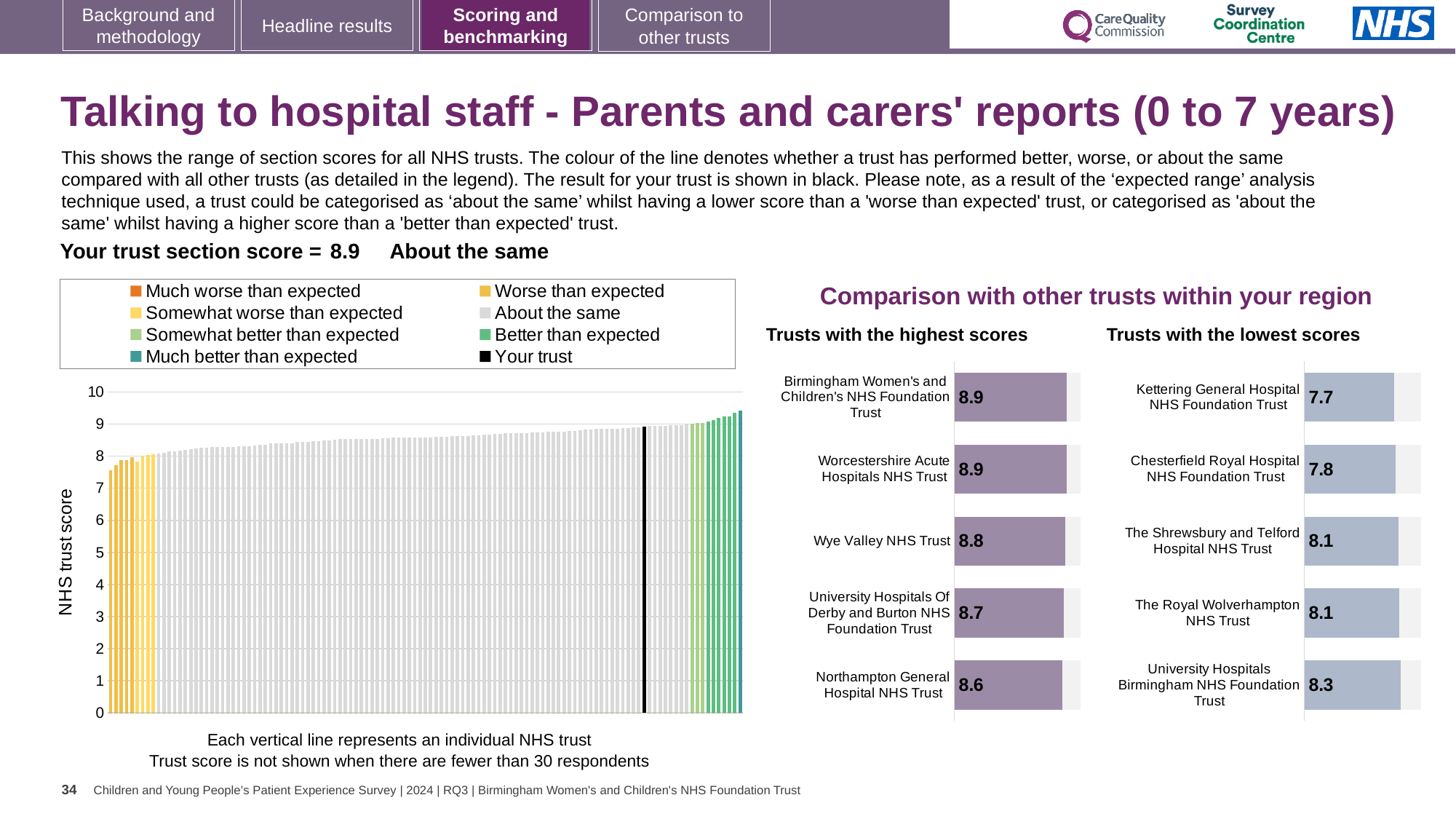
In the 'Trusts with the lowest scores' chart, what is the score for Kettering General Hospital NHS Foundation Trust? 7.7 What type of chart is the NHS trust score chart on the left of the slide? Bar chart In the 'Trusts with the highest scores' chart, what is the score for Northampton General Hospital NHS Trust? 8.6 In the 'Trusts with the lowest scores' chart, which trust has the highest score? University Hospitals Birmingham NHS Foundation Trust How many entries does the legend of the NHS trust score chart on the left list? 8 In the 'Trusts with the lowest scores' chart, which has the higher score: Chesterfield Royal Hospital NHS Foundation Trust or The Royal Wolverhampton NHS Trust? The Royal Wolverhampton NHS Trust In the 'Trusts with the highest scores' chart, which trust has the lowest score? Northampton General Hospital NHS Trust In the 'Trusts with the highest scores' chart, what is the difference between the scores of Birmingham Women's and Children's NHS Foundation Trust and Northampton General Hospital NHS Trust? 0.3 In the 'Trusts with the highest scores' chart, what is the score for Wye Valley NHS Trust? 8.8 In the 'Trusts with the lowest scores' chart, which trust has the lowest score? Kettering General Hospital NHS Foundation Trust How many trusts are shown in the 'Trusts with the highest scores' chart? 5 In the 'Trusts with the lowest scores' chart, what is the difference between the scores of University Hospitals Birmingham NHS Foundation Trust and Kettering General Hospital NHS Foundation Trust? 0.6